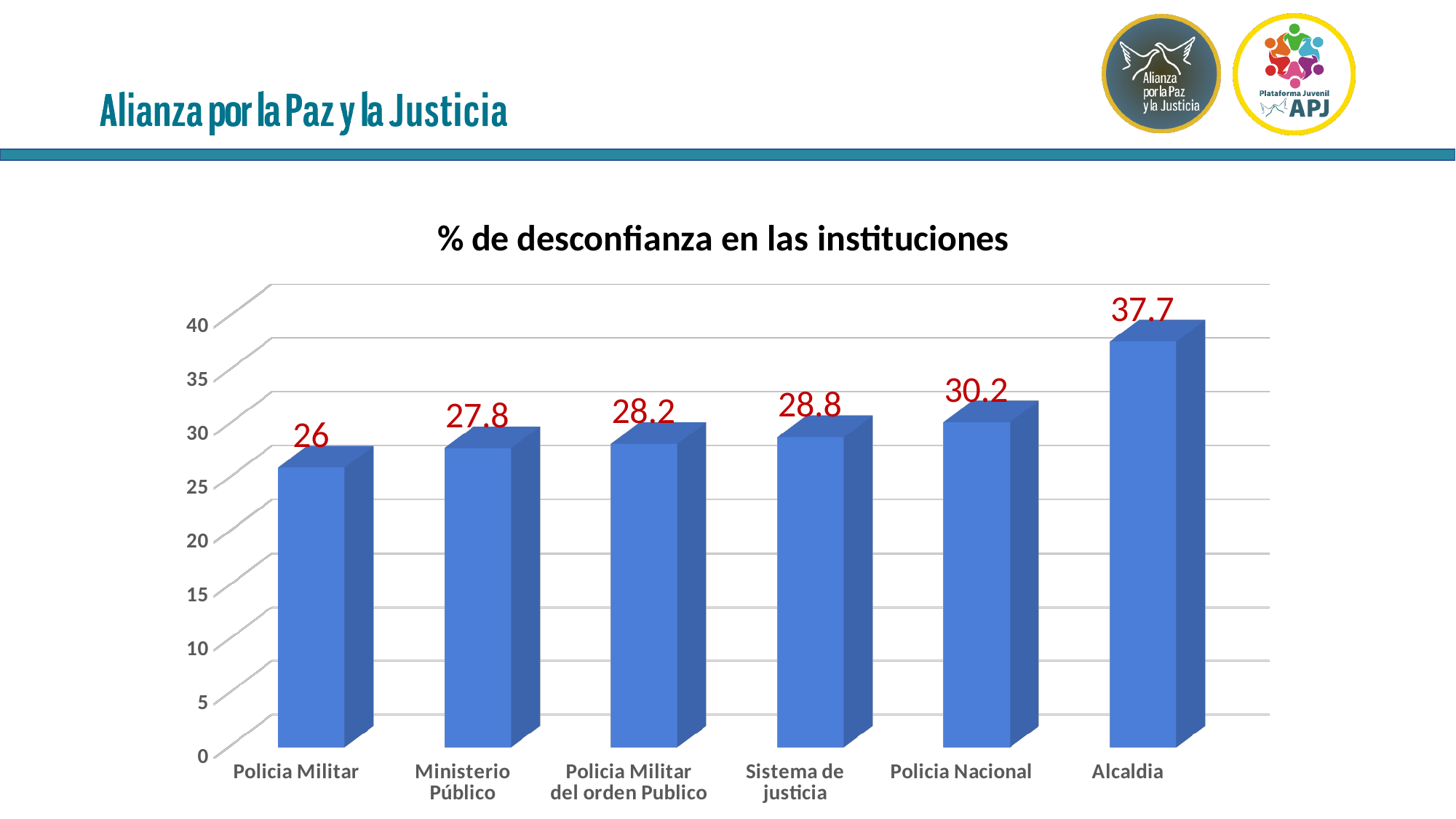
What is the difference between the values for Alcaldia and Policia Militar? 11.7 Which institution has the lowest value? Policia Militar What is the value for Alcaldia? 37.7 What is the value for Policia Militar? 26 Which institution has the highest value? Alcaldia How many institutions are shown on the chart? 6 What is the value for Sistema de justicia? 28.8 What is the title of the chart? % de desconfianza en las instituciones What is the difference between the values for Policia Nacional and Ministerio Público? 2.4 What kind of chart is shown on the slide? Bar chart Which is larger, the value for Policia Nacional or the value for Sistema de justicia? Policia Nacional What is the value for Policia Nacional? 30.2